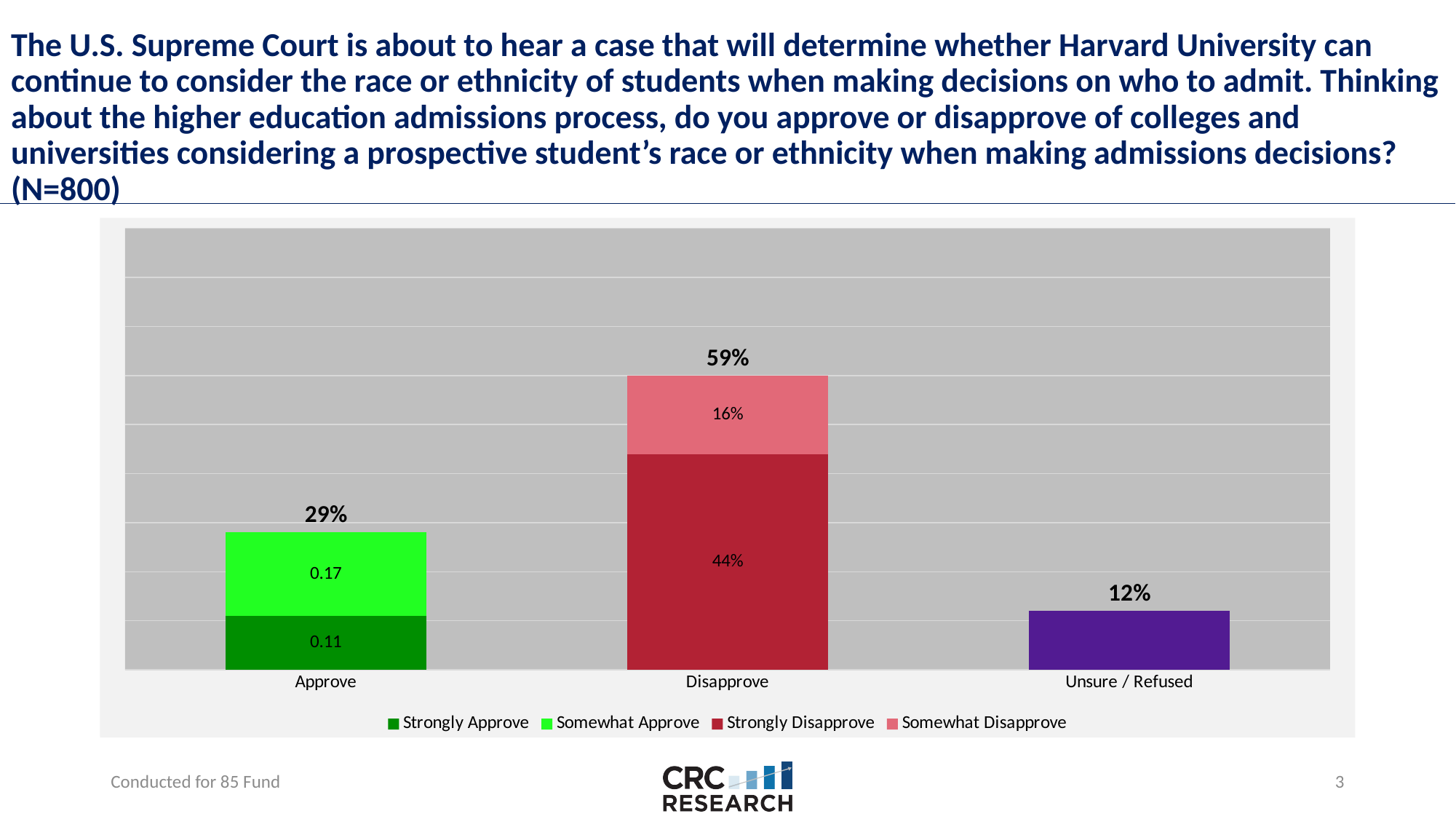
What kind of chart is shown on the slide? Stacked bar chart What is the total value shown above the Approve bar? 29% What is the total value shown above the Disapprove bar? 59% What value is printed on the Somewhat Approve segment of the Approve bar? 0.17 What value is printed on the Strongly Disapprove segment of the Disapprove bar? 44% What is the difference between the Disapprove total and the Approve total? 30 percentage points What value is shown for Unsure / Refused? 12% Within the Disapprove bar, which segment is larger: Strongly Disapprove or Somewhat Disapprove? Strongly Disapprove How many categories are shown on the x axis? 3 How many series does the legend list? 4 Which category has the tallest bar? Disapprove Which category has the shortest bar? Unsure / Refused